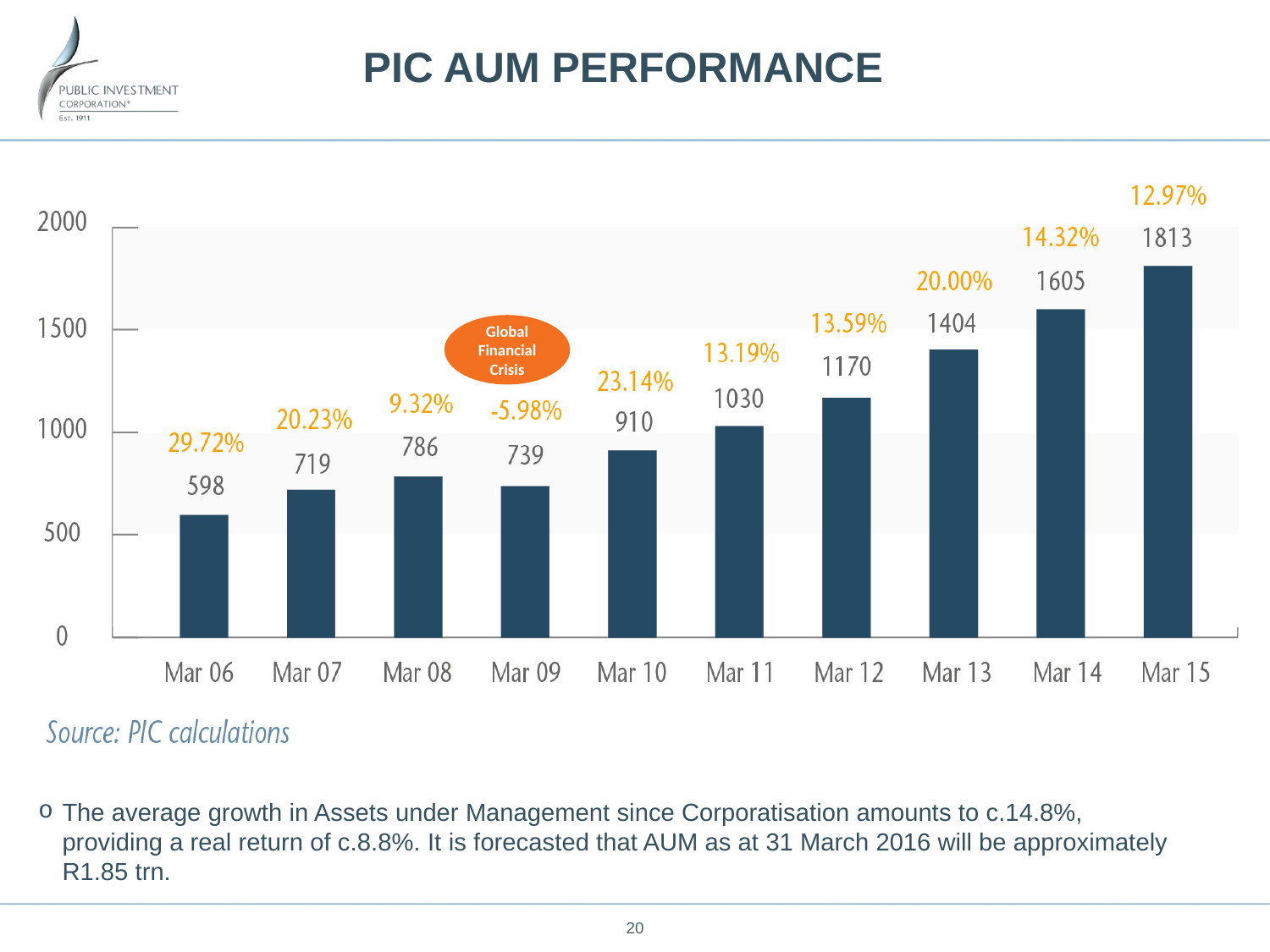
Is the value for Mar 12 greater or less than 1000? greater What growth percentage is shown above the Mar 09 bar? -5.98% Do the AUM values generally rise or fall from Mar 06 to Mar 15? Rise Which year has the lowest AUM value? Mar 06 What is the difference between the AUM values for Mar 15 and Mar 14? 208 What is the AUM value for Mar 13? 1404 What is the AUM value for Mar 10? 910 What kind of chart is shown on the slide? Bar chart Which year has the highest AUM value? Mar 15 What event does the orange oval on the chart label? Global Financial Crisis How many years are shown on the x axis? 10 Which is larger, the AUM value for Mar 08 or Mar 09? Mar 08